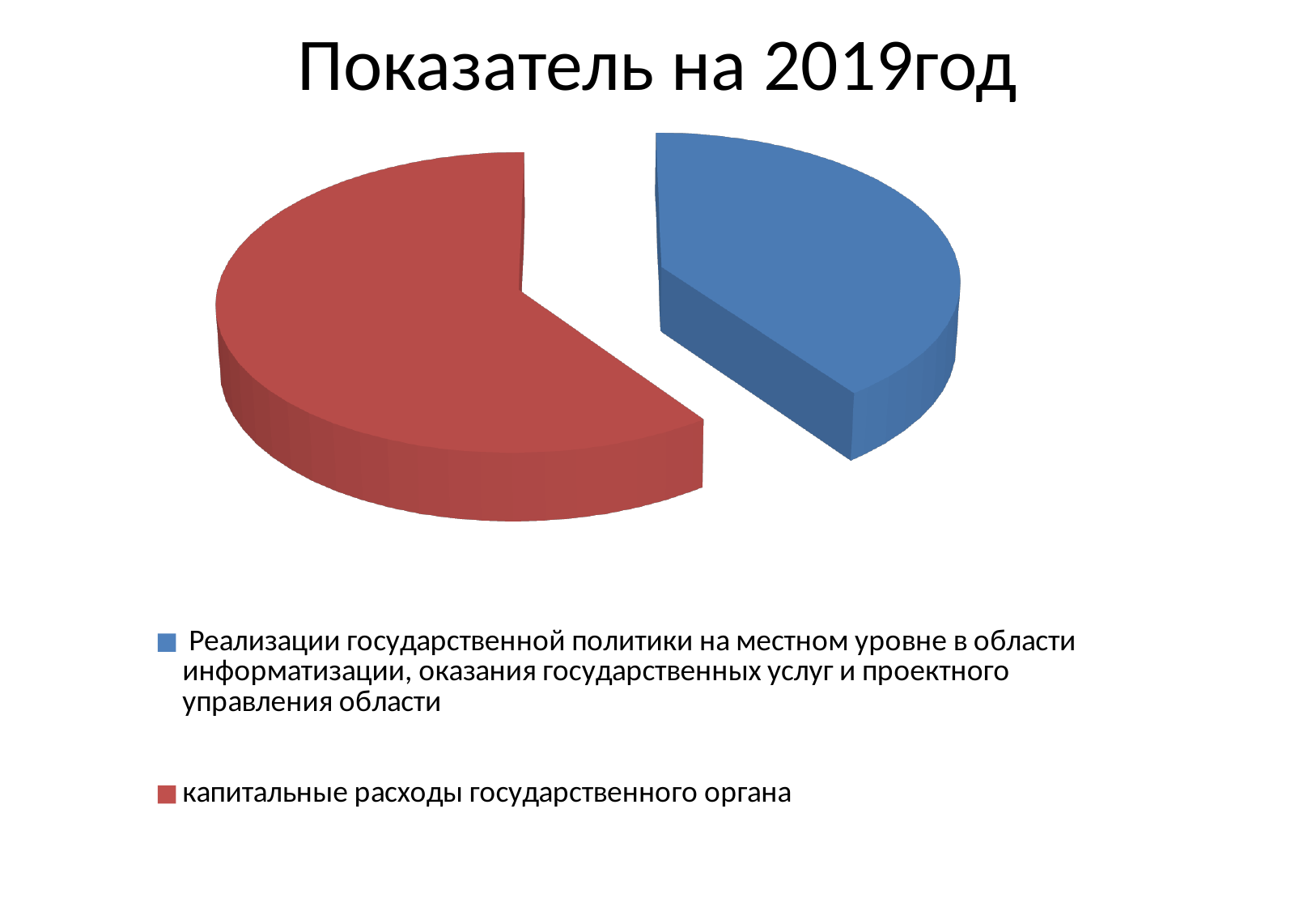
Does the slice for "капитальные расходы государственного органа" take up more or less than half of the pie? more Which category has the smallest slice of the pie? Реализации государственной политики на местном уровне в области информатизации, оказания государственных услуг и проектного управления области Does the slice for "Реализации государственной политики на местном уровне в области информатизации, оказания государственных услуг и проектного управления области" take up more or less than half of the pie? less How many slices does the pie chart have? 2 Which slice is larger: "капитальные расходы государственного органа" or "Реализации государственной политики на местном уровне в области информатизации, оказания государственных услуг и проектного управления области"? капитальные расходы государственного органа What is the title of the chart? Показатель на 2019год Which category has the largest slice of the pie? капитальные расходы государственного органа What colour is the slice for "капитальные расходы государственного органа"? red What kind of chart is shown on the slide? pie chart How many entries does the legend list? 2